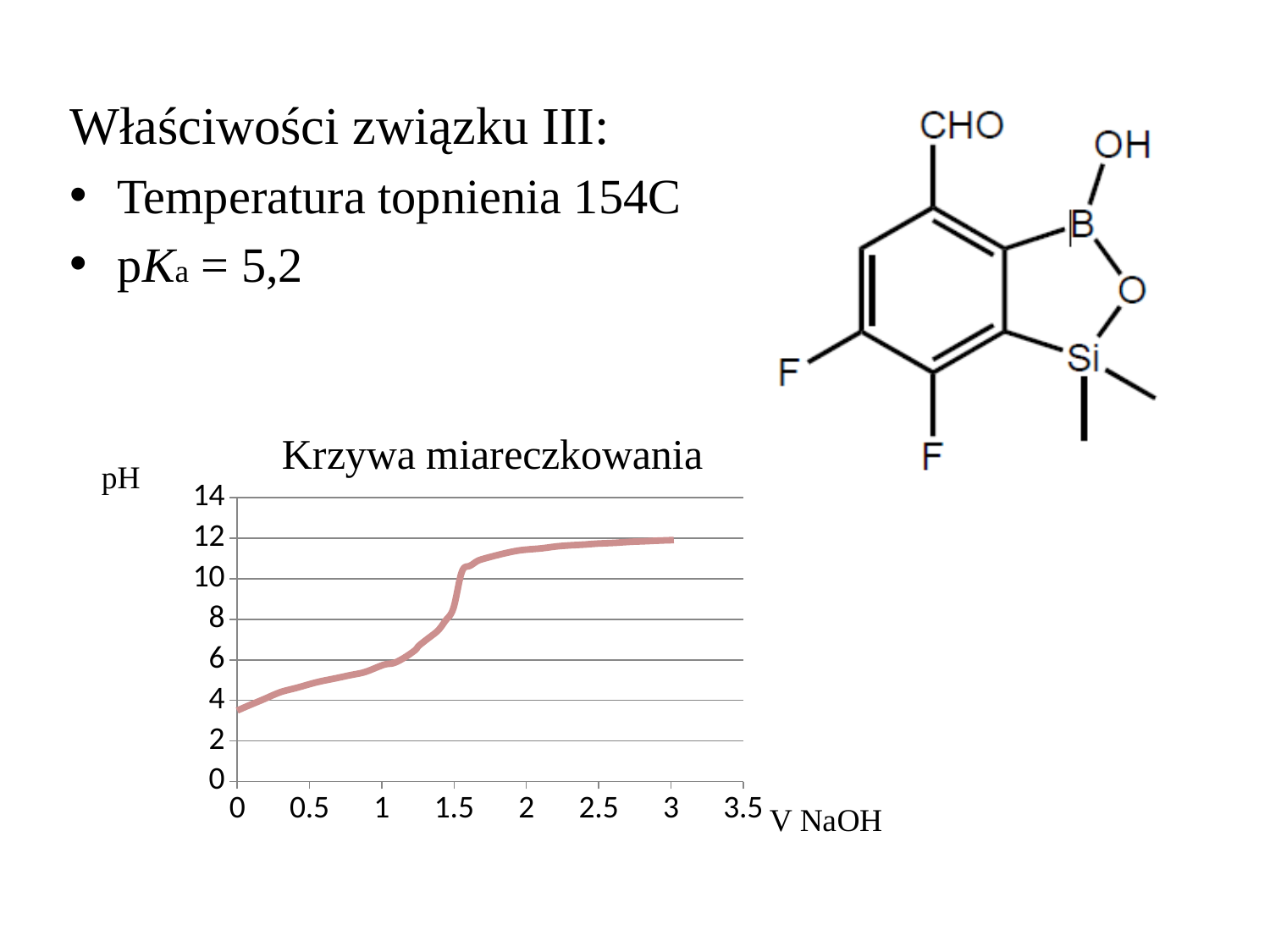
Which has the higher pH on the curve: V NaOH = 0.5 or V NaOH = 2.5? V NaOH = 2.5 What label is shown on the x axis of the chart? V NaOH Is the pH value at V NaOH = 3 greater or less than 14? less What kind of chart is "Krzywa miareczkowania"? line chart Is the pH value at V NaOH = 0 greater or less than 6? less Is the pH value at V NaOH = 1 greater or less than 8? less Does the pH value rise or fall as V NaOH increases along the x axis? rise What is the title of the chart on the slide? Krzywa miareczkowania What is the highest tick value shown on the pH axis? 14